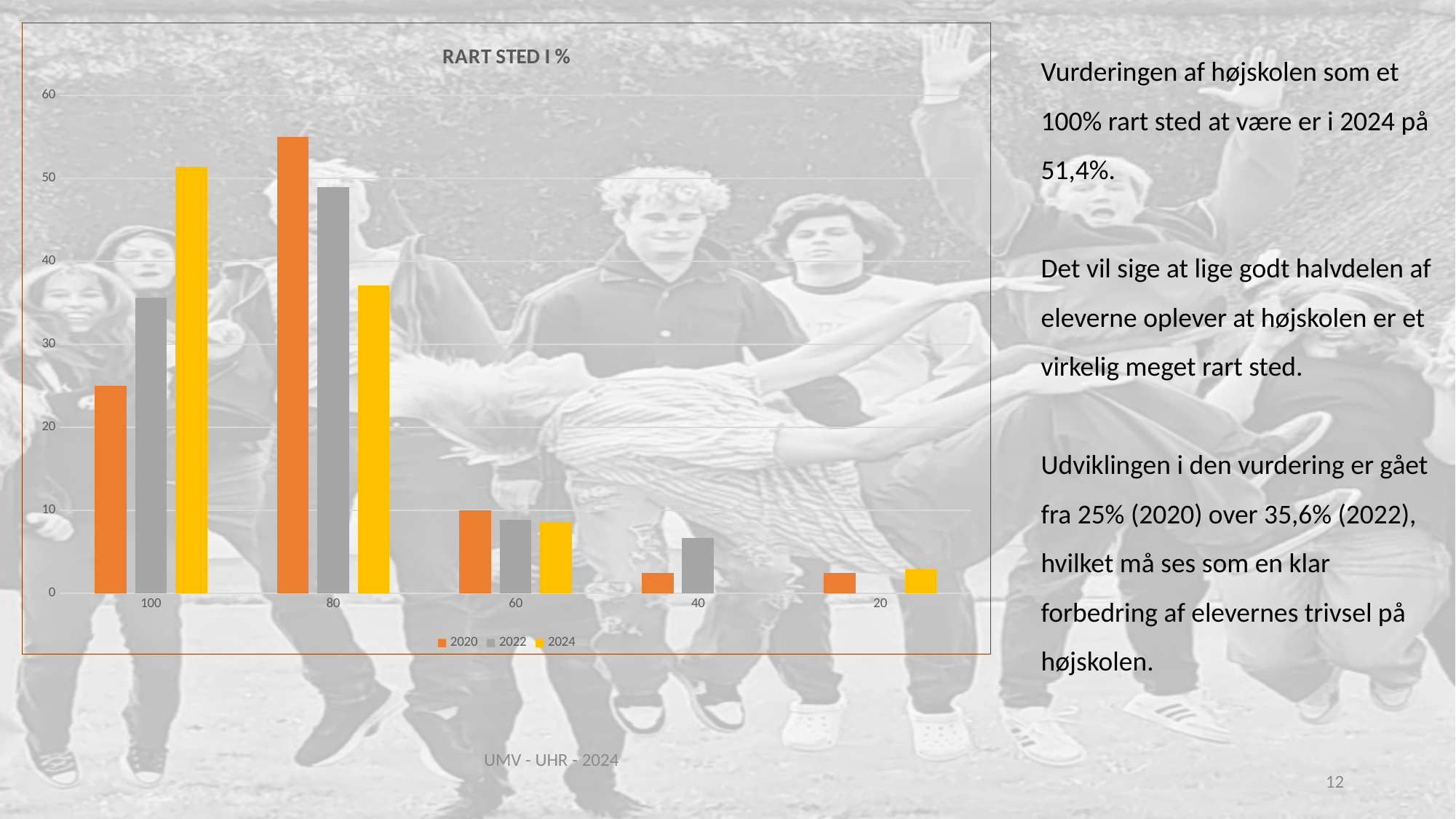
What is the value for 2024 in the 100 category? 51,4% What is the title of the chart? RART STED I % Which series has the highest bar in the 100 category? 2024 How many categories are shown on the x axis of the chart? 5 Is the value for 2024 in the 80 category greater or less than 40? less Which colour represents the 2024 series in the chart? yellow Which series has the highest bar in the 80 category? 2020 What is the value for 2022 in the 100 category? 35,6% What is the value for 2020 in the 100 category? 25% Is the value for 2020 in the 80 category greater or less than 50? greater How many series does the chart legend list? 3 What kind of chart is shown on the slide? bar chart